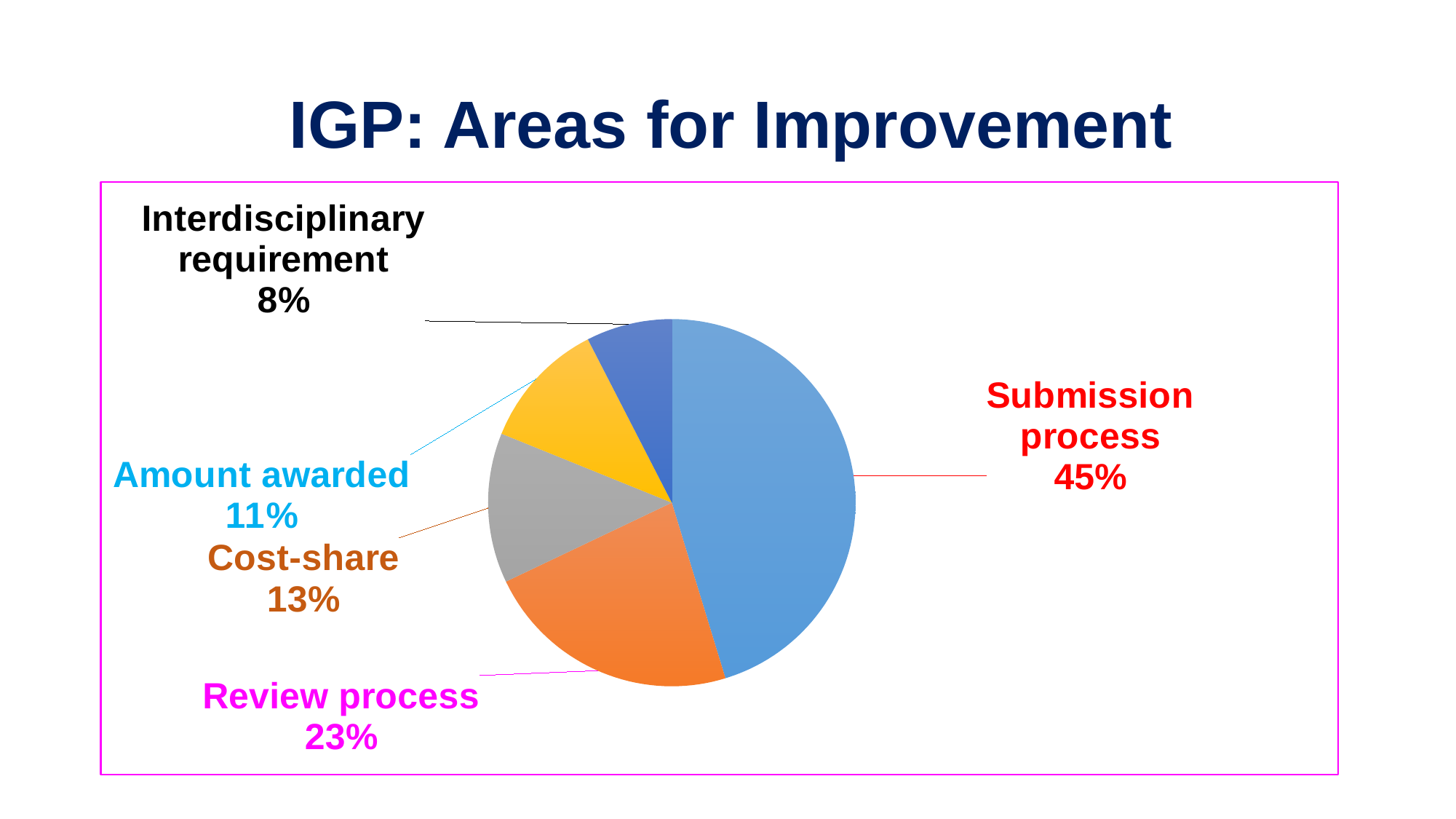
What share of the pie does Interdisciplinary requirement have? 8% What share of the pie does Amount awarded have? 11% What share of the pie does Submission process have? 45% Which category has the smallest slice of the pie? Interdisciplinary requirement How many categories are shown in the pie chart? 5 What kind of chart is shown on the slide? pie chart What is the title of the slide containing the chart? IGP: Areas for Improvement What is the difference in percentage points between Submission process and Review process? 22 Which category has the largest slice of the pie? Submission process Which is larger, Cost-share or Amount awarded? Cost-share